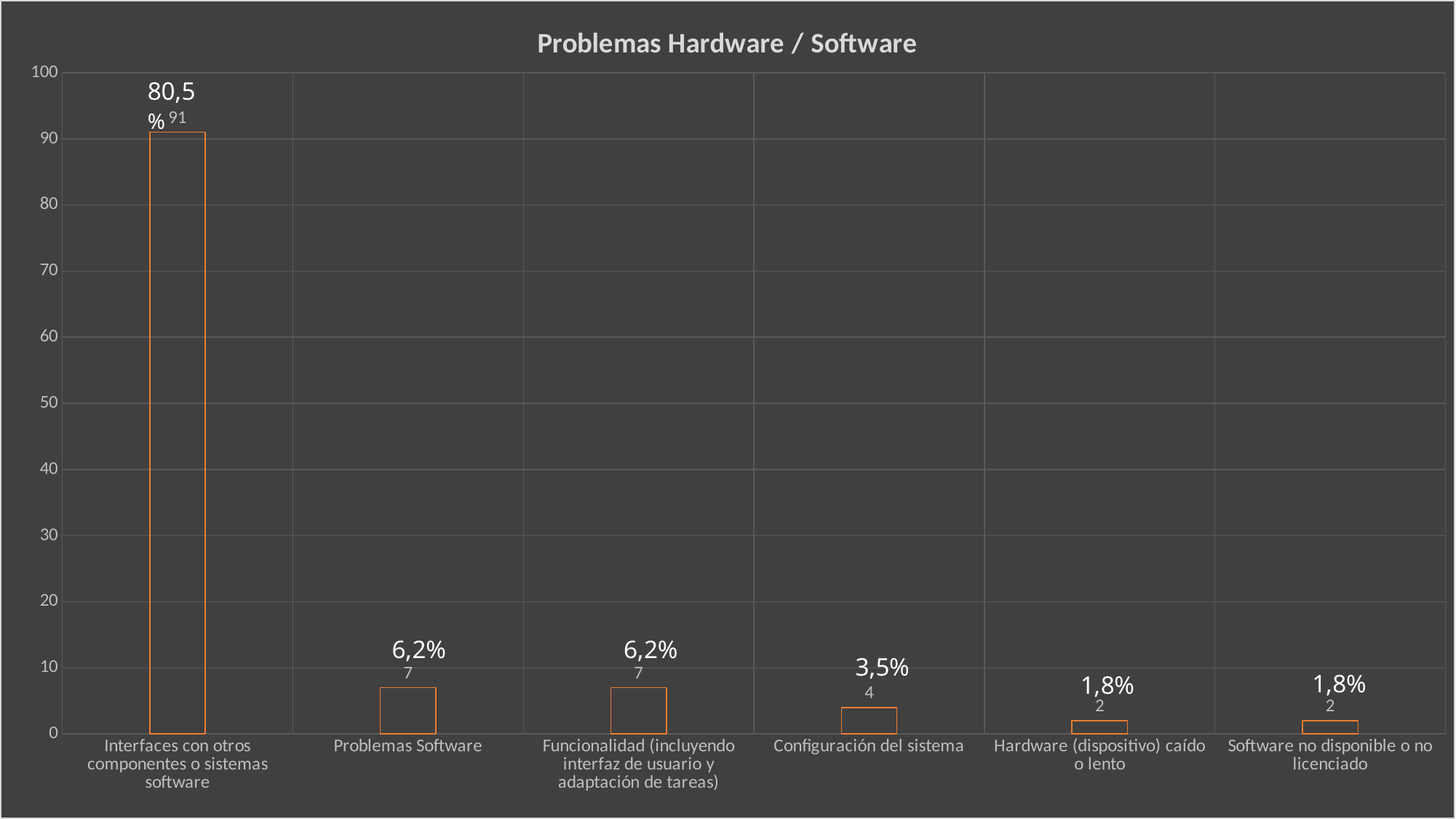
How many categories are shown on the chart? 6 What is the value for 'Problemas Software'? 7 Which category has the highest value? Interfaces con otros componentes o sistemas software What is the difference between the values for 'Configuración del sistema' and 'Hardware (dispositivo) caído o lento'? 2 What percentage is shown for 'Configuración del sistema'? 3,5% What is the difference between the values for 'Interfaces con otros componentes o sistemas software' and 'Problemas Software'? 84 Which is larger, the value for 'Funcionalidad (incluyendo interfaz de usuario y adaptación de tareas)' or 'Configuración del sistema'? Funcionalidad (incluyendo interfaz de usuario y adaptación de tareas) What is the value for 'Interfaces con otros componentes o sistemas software'? 91 What percentage is shown for 'Software no disponible o no licenciado'? 1,8% What is the title of the chart? Problemas Hardware / Software What kind of chart is shown? Bar chart Is the value for 'Interfaces con otros componentes o sistemas software' greater or less than 80? greater